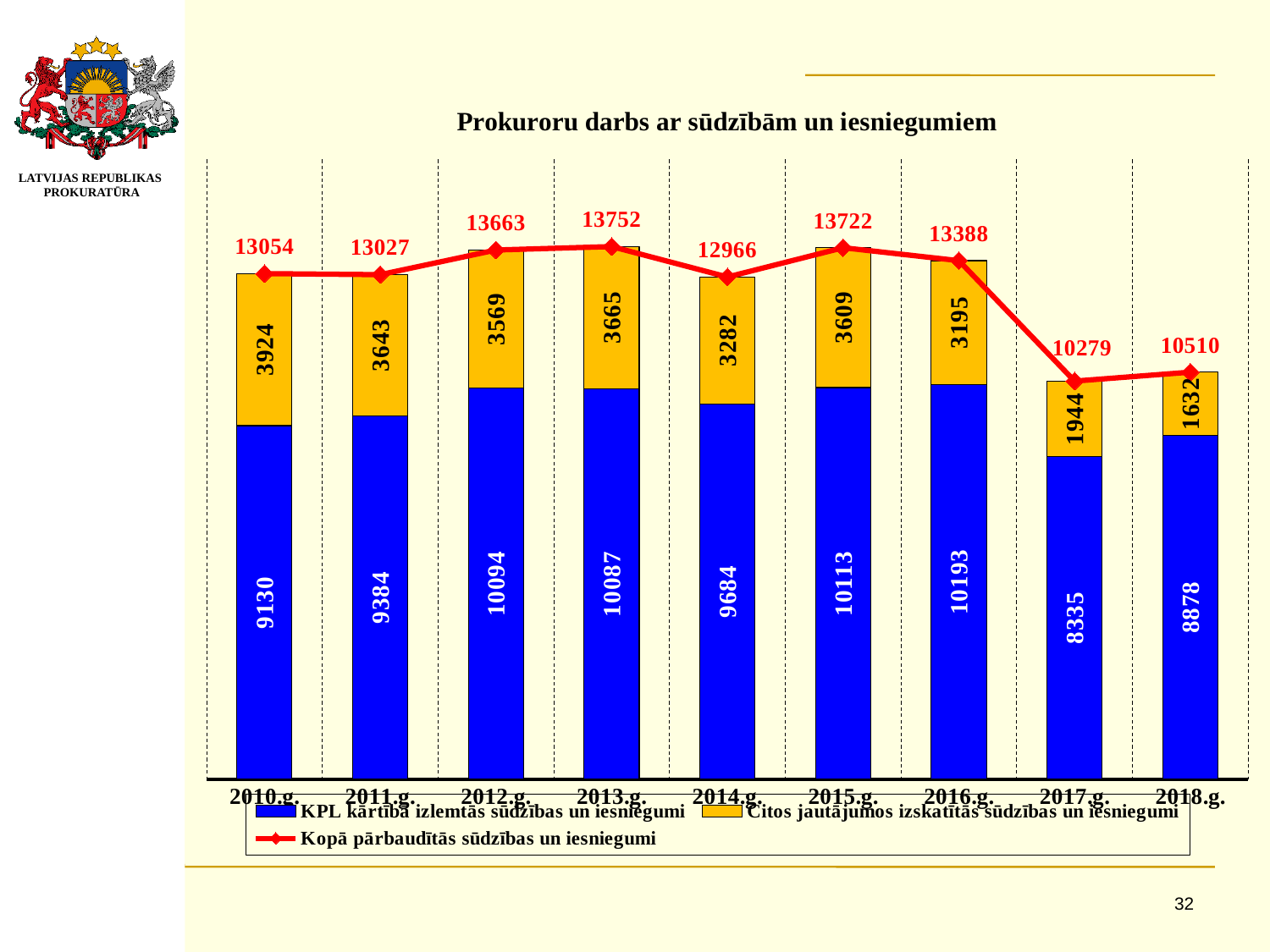
What is the value of the yellow series (Citos jautājumos izskatītās sūdzības un iesniegumi) for 2016.g.? 3195 Does the total (Kopā pārbaudītās sūdzības un iesniegumi) rise or fall from 2016.g. to 2017.g.? Fall What is the value of the blue series (KPL kārtībā izlemtās sūdzības un iesniegumi) for 2013.g.? 10087 What kind of chart is shown on the slide? Stacked bar chart with a line What is the title of the chart? Prokuroru darbs ar sūdzībām un iesniegumiem In which year is the yellow series (Citos jautājumos izskatītās sūdzības un iesniegumi) lowest? 2018.g. What is the value of the red line (Kopā pārbaudītās sūdzības un iesniegumi) for 2014.g.? 12966 What is the difference between the total for 2017.g. and the total for 2018.g.? 231 How many years are shown on the x axis? 9 In which year is the total (Kopā pārbaudītās sūdzības un iesniegumi) highest? 2013.g. Which is larger: the blue series value for 2015.g. or for 2016.g.? 2016.g. How many series does the legend list? 3